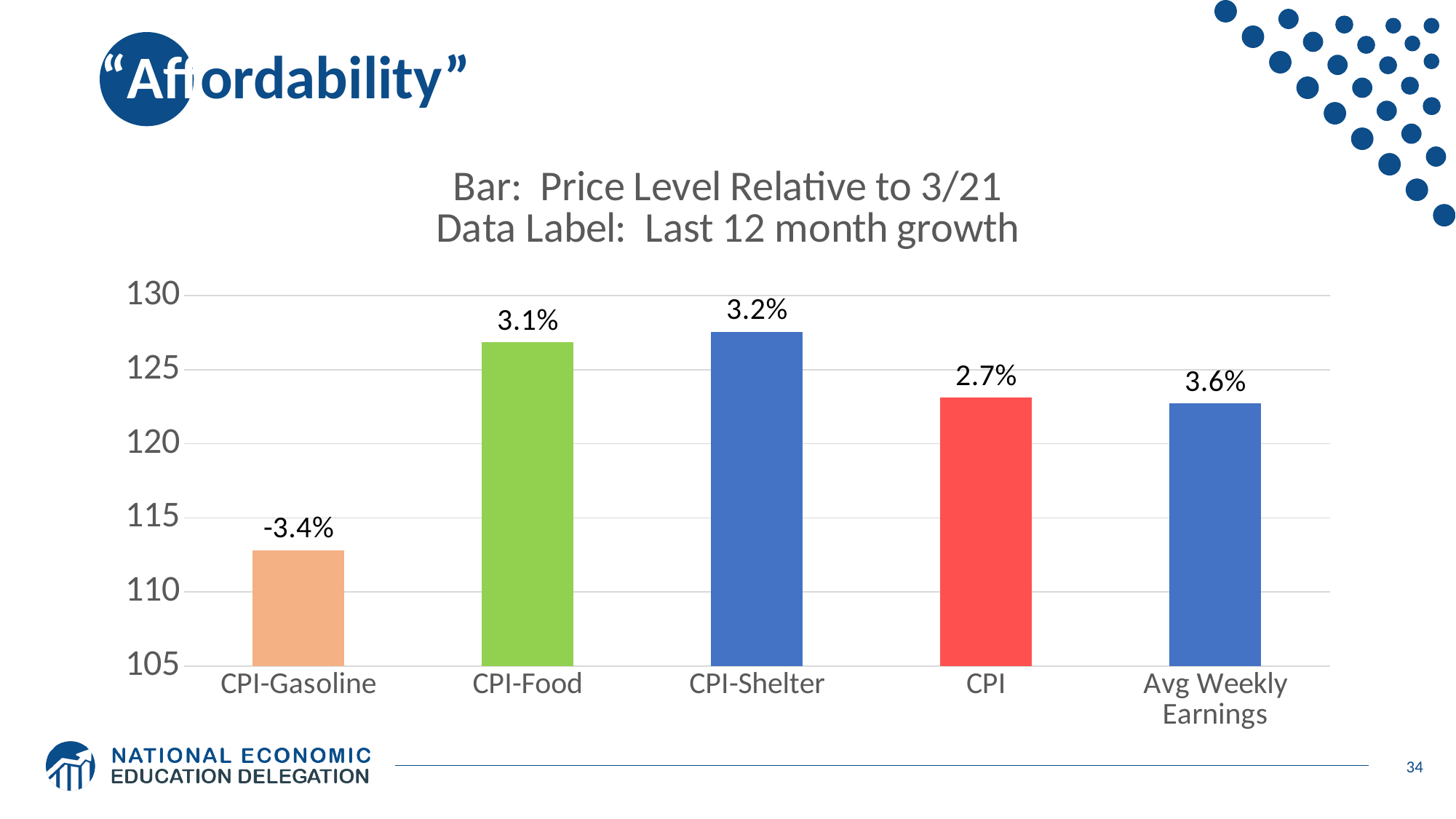
What kind of chart is shown on the slide? Bar chart What is the difference between the data labels for Avg Weekly Earnings and CPI? 0.9 percentage points Which bar is taller, CPI-Food or CPI? CPI-Food Is the bar for CPI-Food greater or less than 125? greater Which category has the lowest bar (price level relative to 3/21)? CPI-Gasoline What is the data label shown for CPI-Gasoline? -3.4% How many categories are shown on the x axis? 5 What is the data label (last 12 month growth) shown for CPI-Food? 3.1% What is the last 12 month growth shown for Avg Weekly Earnings? 3.6% Which category has the highest last 12 month growth data label? Avg Weekly Earnings What is the data label shown for CPI-Shelter? 3.2% Is the bar for CPI-Gasoline greater or less than 115? less